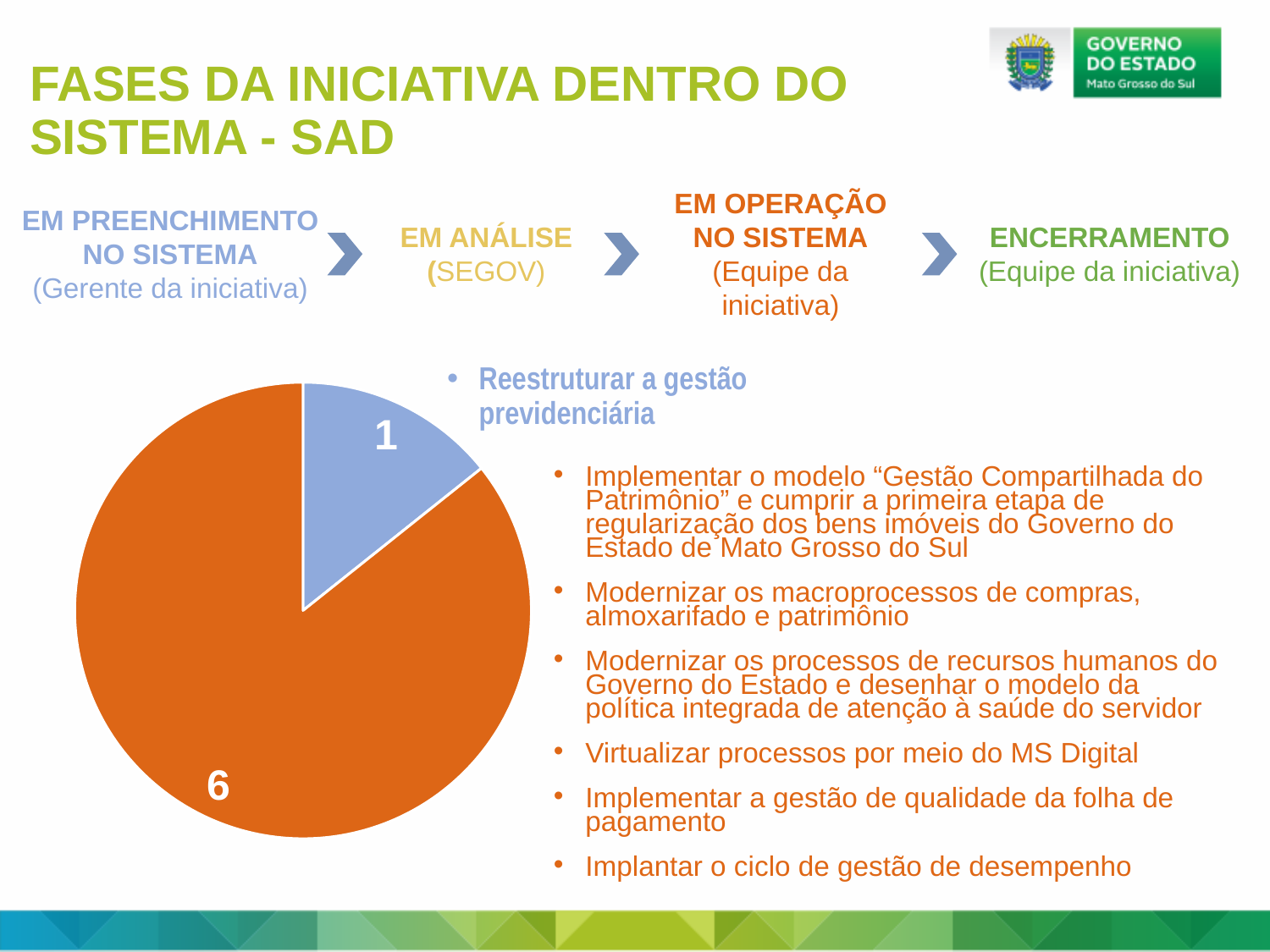
Which slice of the pie chart is the smallest? the blue slice (1) What is the total of the values shown on the pie chart? 7 What is the difference between the orange slice value and the blue slice value in the pie chart? 5 Does the pie chart have a legend? No What kind of chart is shown on the slide? pie chart Which slice of the pie chart is the largest? the orange slice (6) Which is larger in the pie chart, the orange slice or the blue slice? the orange slice What two colours are used for the slices of the pie chart? orange and blue What value is shown on the orange slice of the pie chart? 6 How many slices does the pie chart have? 2 What value is shown on the blue slice of the pie chart? 1